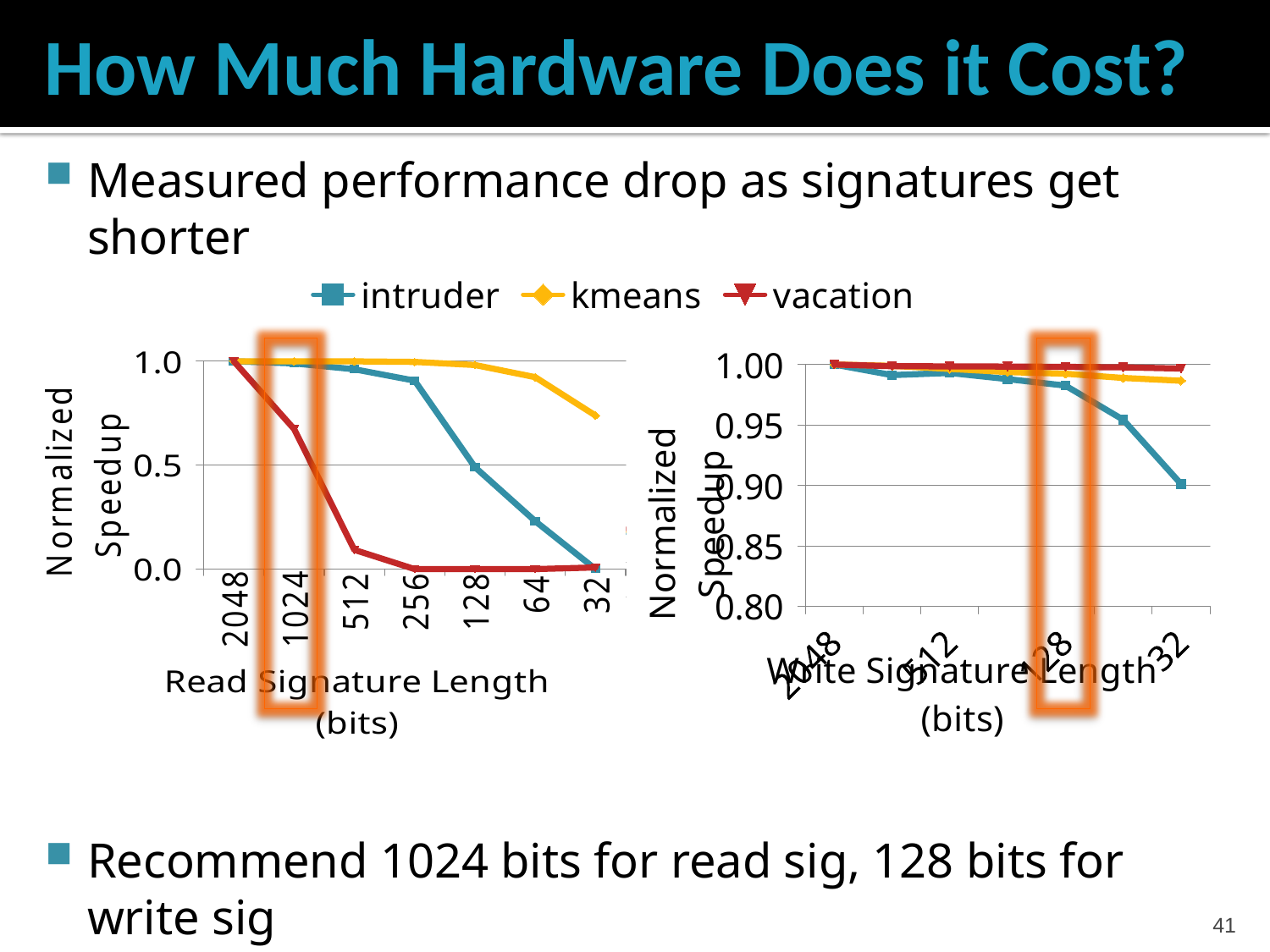
Which series are listed in the legend? intruder, kmeans, vacation How many series does the legend list? 3 In the Write Signature Length chart on the right, which series has the lowest value at 32 bits? intruder In the Read Signature Length chart on the left, is the value for intruder at 64 bits greater or less than 0.5? less In the Read Signature Length chart on the left, is the value for vacation at 512 bits greater or less than 0.5? less In the Read Signature Length chart on the left, which series has the highest value at 32 bits? kmeans In the Write Signature Length chart on the right, is the value for intruder at 32 bits greater or less than 0.95? less What kind of chart is the Read Signature Length chart on the left? line chart In the Read Signature Length chart on the left, how many signature lengths are plotted along the x axis? 7 In the Read Signature Length chart on the left, does the intruder line rise or fall moving from 2048 bits to 32 bits along the x axis? fall